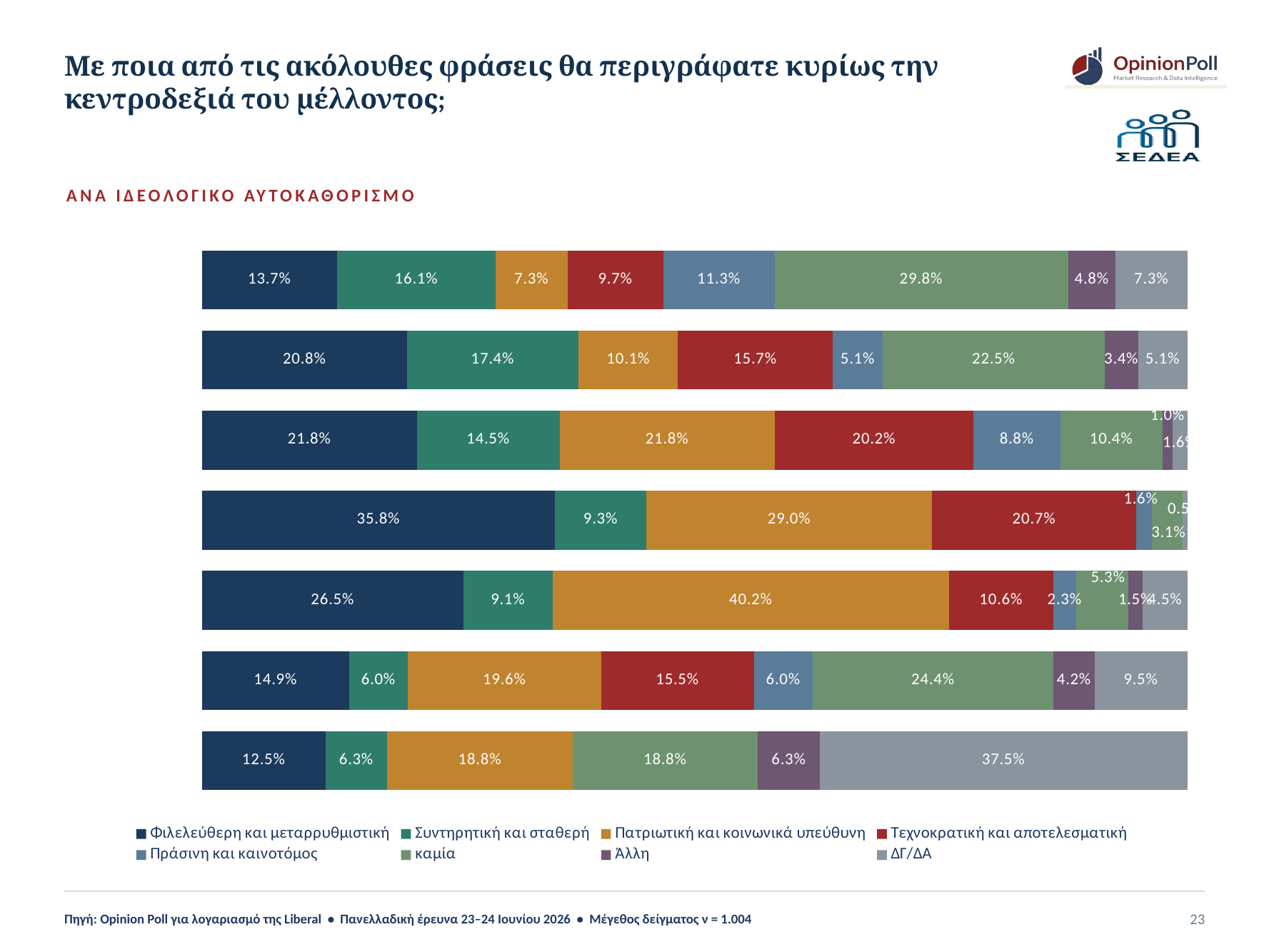
In the fifth bar from the top, which series has the largest segment? Πατριωτική και κοινωνικά υπεύθυνη In the bottom bar, what is the value for 'ΔΓ/ΔΑ'? 37.5% In the second bar from the top, which is larger: 'Φιλελεύθερη και μεταρρυθμιστική' or 'Συντηρητική και σταθερή'? Φιλελεύθερη και μεταρρυθμιστική Which bar has the largest 'Φιλελεύθερη και μεταρρυθμιστική' segment? The fourth bar from the top (35.8%) In the bottom bar, what is the difference between 'ΔΓ/ΔΑ' and 'Φιλελεύθερη και μεταρρυθμιστική'? 25.0 percentage points How many series does the legend list? 8 In the top bar, what is the value for 'καμία'? 29.8% In the sixth bar from the top, what is the value for 'Τεχνοκρατική και αποτελεσματική'? 15.5% What colour represents 'ΔΓ/ΔΑ' in the legend? Grey In the fourth bar from the top, what is the value for 'Φιλελεύθερη και μεταρρυθμιστική'? 35.8% How many bars (rows) does the chart contain? 7 What kind of chart is shown on the slide? Stacked bar chart